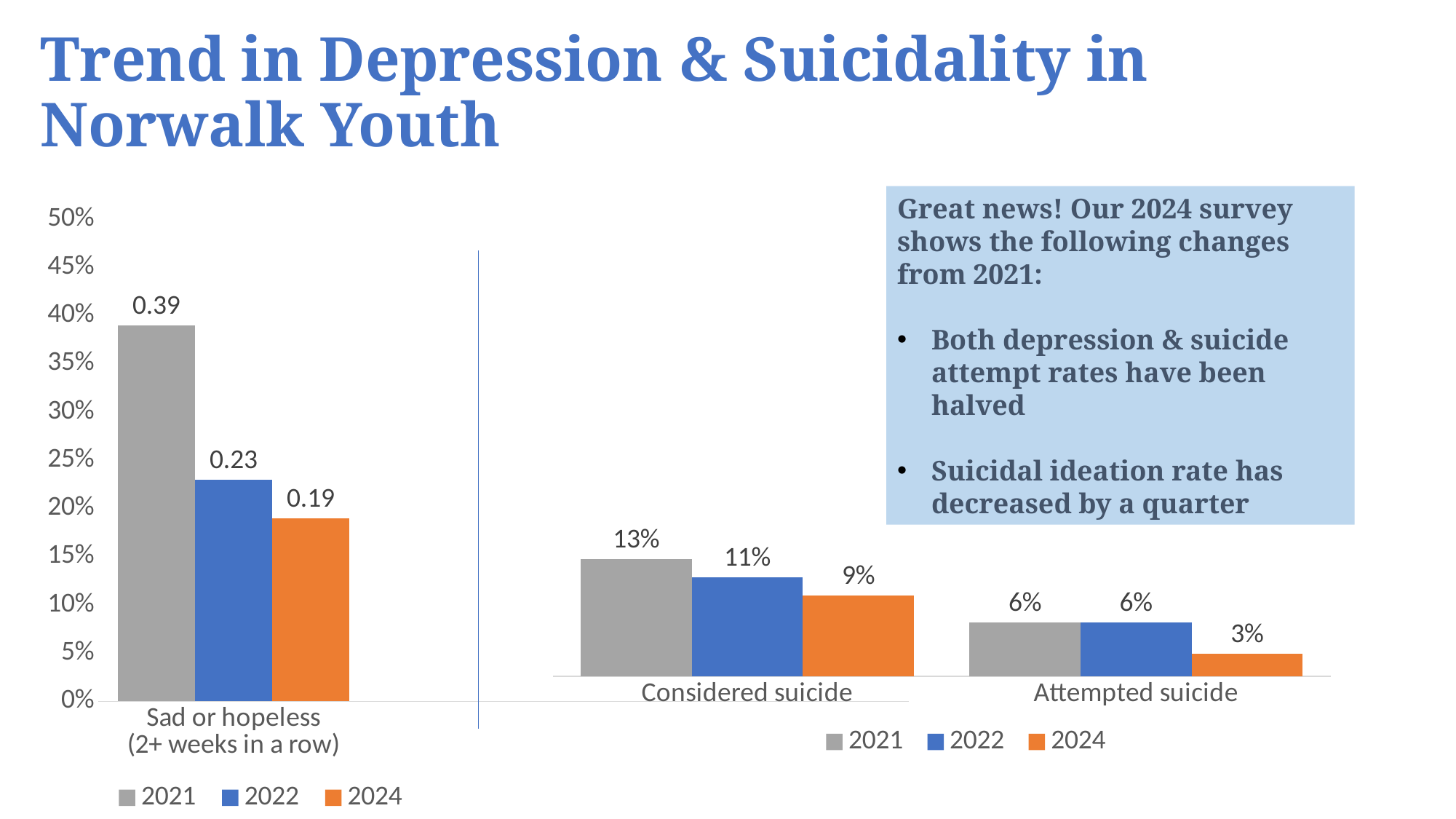
How many series does the legend of the right chart list? 3 In the right chart, do the values for Considered suicide rise or fall from 2021 to 2024? Fall In the right chart, what is the value for 2024 for Attempted suicide? 3% In the right chart, which is larger for Attempted suicide: the 2022 value or the 2024 value? 2022 In the left chart, which year has the lowest value for Sad or hopeless (2+ weeks in a row)? 2024 In the left chart, what is the value for 2021 for Sad or hopeless (2+ weeks in a row)? 0.39 In the right chart, what is the value for 2022 for Considered suicide? 11% What kind of chart is the left chart? Bar chart In the right chart, which year has the highest value for Considered suicide? 2021 In the right chart, what is the difference between the 2021 and 2024 values for Considered suicide? 4% In the left chart, what is the difference between the 2021 and 2022 values for Sad or hopeless (2+ weeks in a row)? 0.16 In the left chart, what is the value for 2024 for Sad or hopeless (2+ weeks in a row)? 0.19